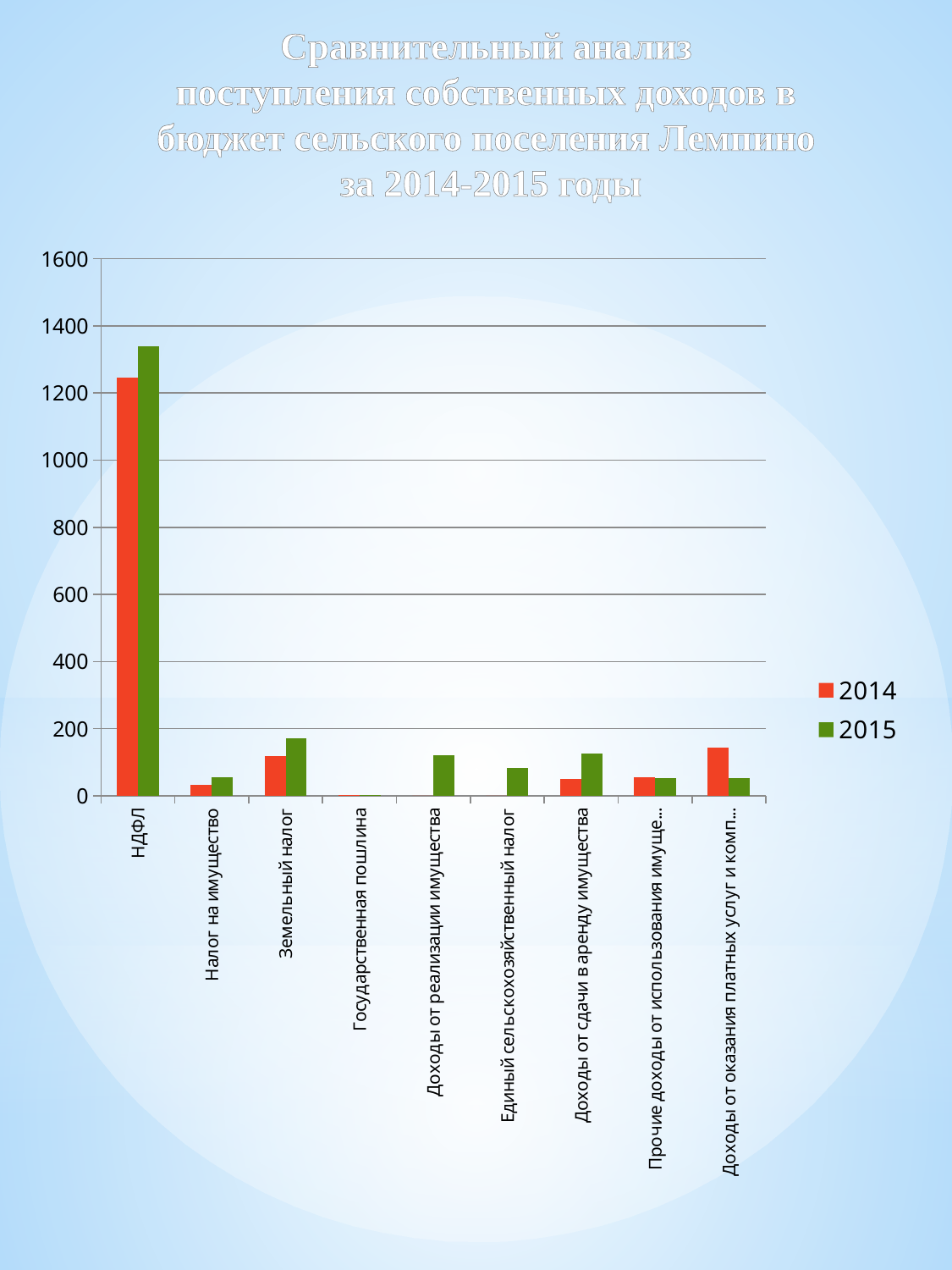
Is the 2015 value for НДФЛ greater or less than 1200? greater How many categories are shown on the x axis? 9 For Доходы от оказания платных услуг, which year has the larger value, 2014 or 2015? 2014 For Доходы от сдачи в аренду имущества, which year has the larger value, 2014 or 2015? 2015 Which colour represents the 2015 series in the legend? green Is the 2014 value for НДФЛ greater or less than 1000? greater Is the 2015 value for Земельный налог greater or less than 200? less Which category has the highest value for 2015? НДФЛ For НДФЛ, which year has the larger value, 2014 or 2015? 2015 Which category has the highest value for 2014? НДФЛ How many series does the legend list? 2 What kind of chart is shown on the slide? bar chart